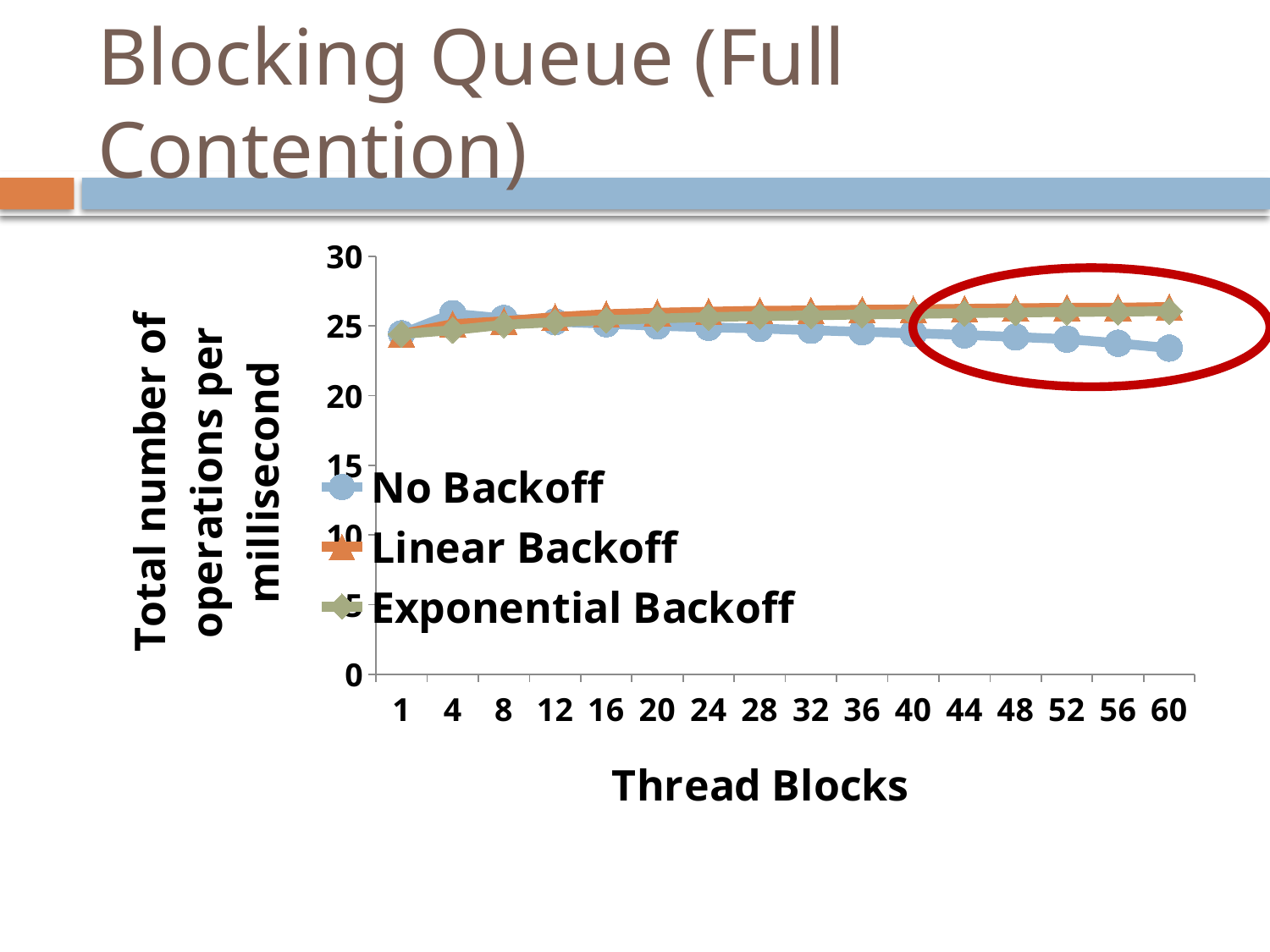
Does the No Backoff series rise or fall from 40 to 60 thread blocks? fall What is the title of the x axis? Thread Blocks Is the value for No Backoff at 1 thread block greater or less than 20? greater What is the title of the y axis? Total number of operations per millisecond Is the value for No Backoff at 60 thread blocks greater or less than 25? less What kind of chart is shown on the slide? line chart How many thread block values are plotted along the x axis? 16 Which series has the lowest value at 60 thread blocks? No Backoff How many series does the legend list? 3 At 60 thread blocks, which is larger: Linear Backoff or No Backoff? Linear Backoff Does the Linear Backoff series rise or fall from 1 to 60 thread blocks? rise Is the value for Linear Backoff at 60 thread blocks greater or less than 25? greater